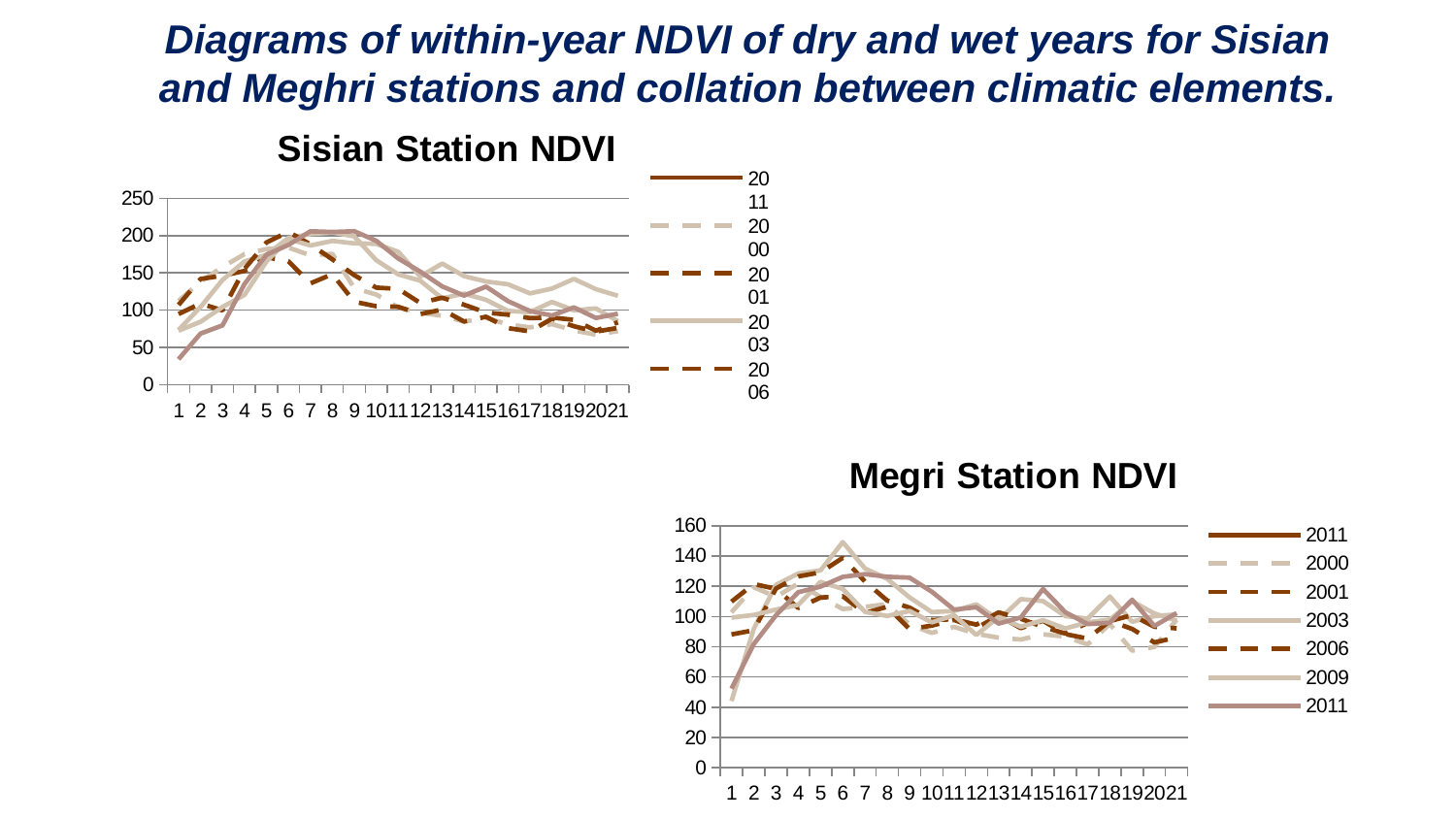
How many series does the legend of the Sisian Station NDVI chart list? 5 In the Sisian Station NDVI chart, is the value of the 2011 series at point 8 greater or less than 150? greater In the Megri Station NDVI chart, do the values of the 2009 series rise or fall from point 1 to point 6? rise What kind of chart is the Sisian Station NDVI chart? line chart In the Megri Station NDVI chart, is the value of the 2009 series at point 6 greater or less than 140? less In the Sisian Station NDVI chart, do the values of the 2011 series generally rise or fall from point 9 to point 21? fall How many points are plotted along the x axis of the Sisian Station NDVI chart? 21 In the Megri Station NDVI chart, is the value of the 2011 series at point 1 greater or less than 80? less How many points are plotted along the x axis of the Megri Station NDVI chart? 21 What is the highest value shown on the y axis of the Megri Station NDVI chart? 160 What kind of chart is the Megri Station NDVI chart? line chart How many series does the legend of the Megri Station NDVI chart list? 7